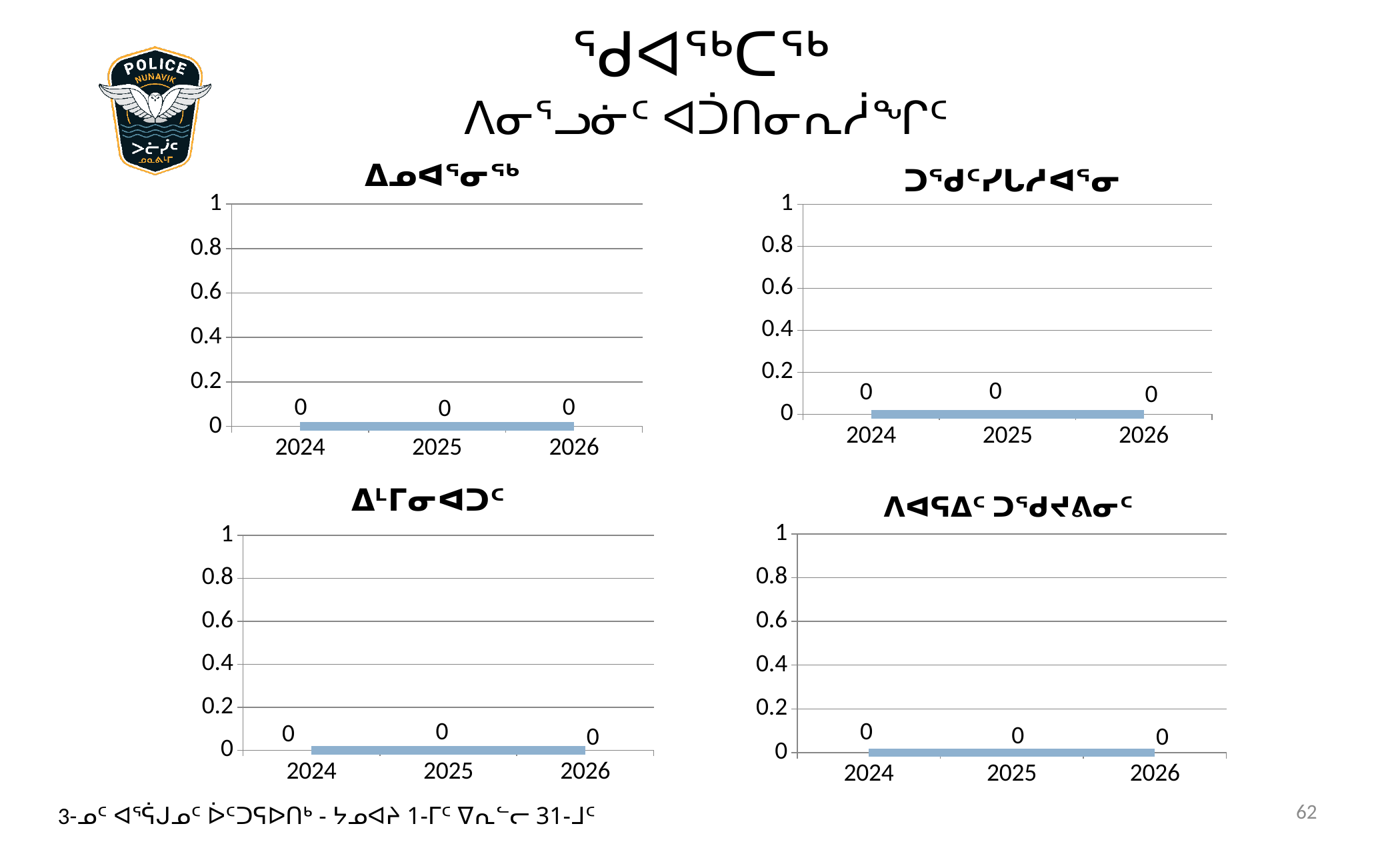
In the top-right chart, is the value for 2026 greater or less than 0.2? less In the bottom-right chart, what is the value for 2024? 0 What is the highest tick value on the y axis of the bottom-left chart? 1 How many years are plotted in the bottom-right chart? 3 How many charts are shown on the slide? 4 How many categories are shown on the x axis of the top-left chart? 3 In the bottom-right chart, is the value for 2025 greater or less than 0.4? less What kind of chart is the top-right chart? line chart Do the values in the bottom-left chart rise, fall, or stay the same from 2024 to 2026? stay the same In the bottom-left chart, what is the value for 2026? 0 In the top-right chart, what is the value for 2025? 0 In the top-left chart, what is the value for 2024? 0